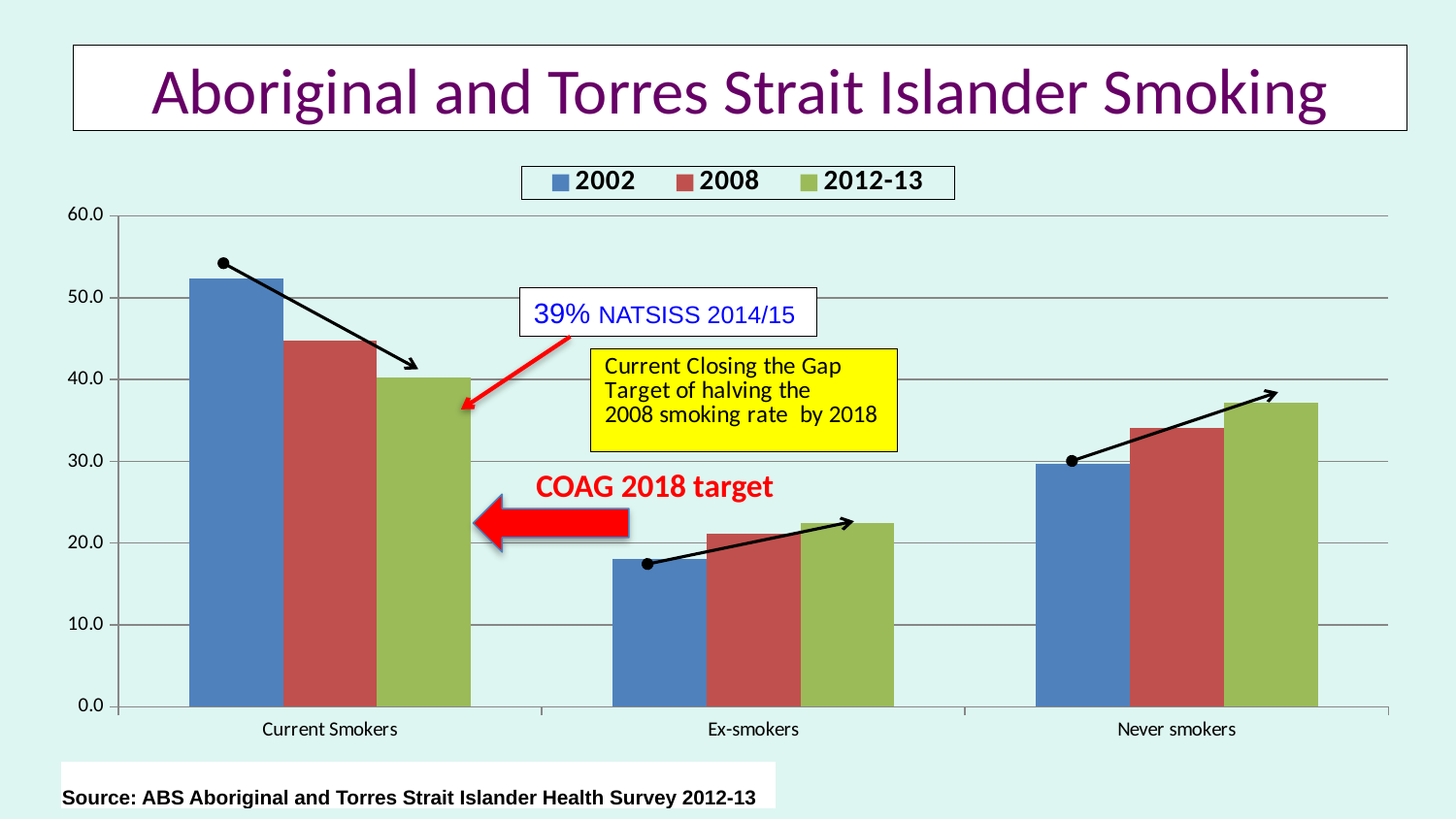
Is the 2002 value for Ex-smokers greater or less than 20? less Which series are listed in the chart's legend? 2002, 2008, 2012-13 Is the 2012-13 value for Never smokers greater or less than 40? less Which category has the lowest value for the 2012-13 series? Ex-smokers Do the values for Current Smokers rise or fall from 2002 to 2012-13? fall Which category has the highest value for the 2002 series? Current Smokers How many series does the chart's legend list? 3 How many categories are shown on the x axis of the chart? 3 What kind of chart is shown on the slide? Bar chart For Current Smokers, which is larger: the 2002 value or the 2012-13 value? 2002 For Never smokers, which is larger: the 2002 value or the 2012-13 value? 2012-13 Is the 2002 value for Current Smokers greater or less than 50? greater